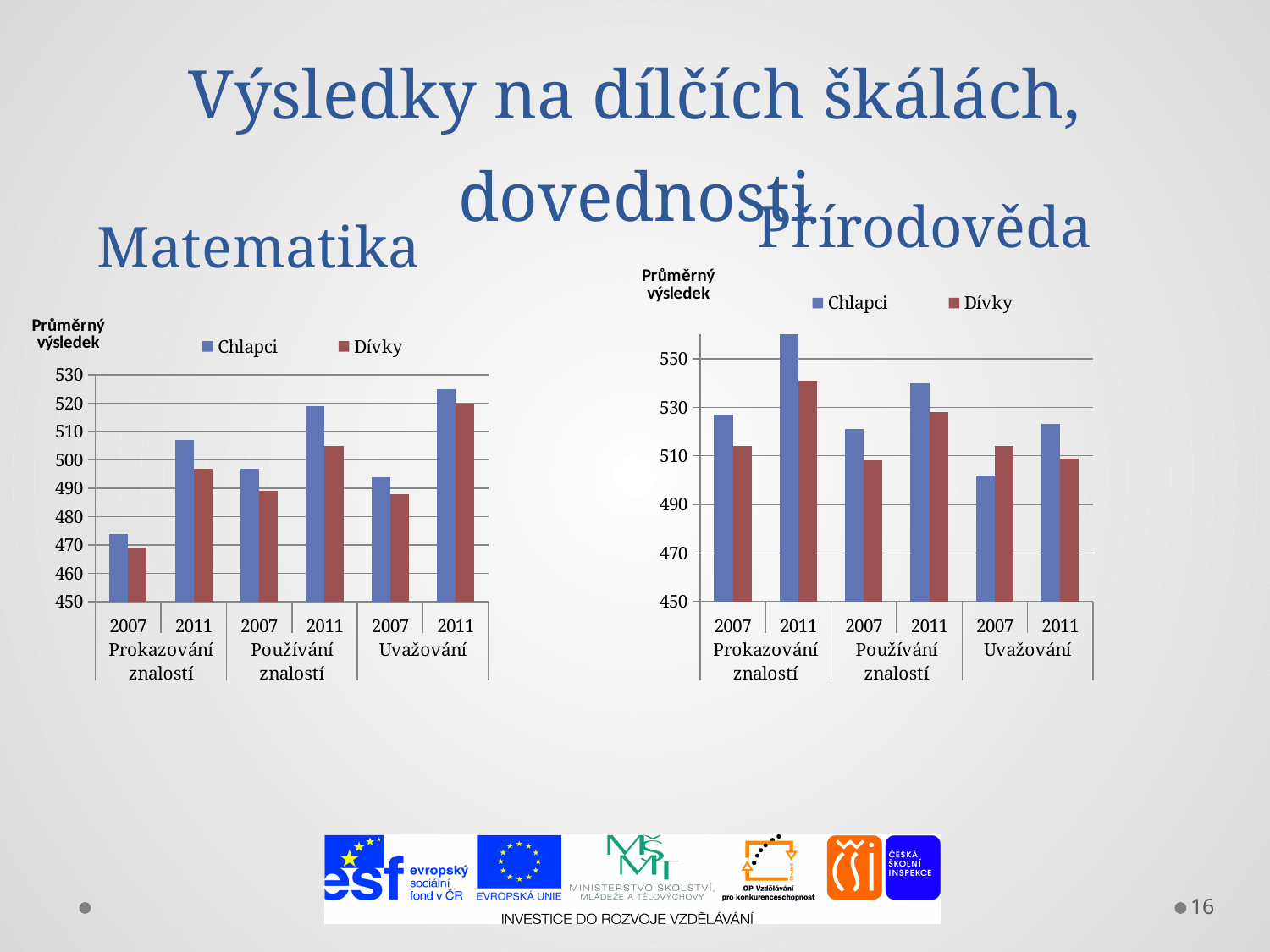
In the Přírodověda chart, which bar is the highest? Chlapci, 2011 Prokazování znalostí In the Matematika chart, is the Dívky value for 2007 Prokazování znalostí greater or less than 480? less In the Přírodověda chart, is the Chlapci value for 2007 Uvažování greater or less than 510? less In the Matematika chart, which bar is the lowest? Dívky, 2007 Prokazování znalostí In the Přírodověda chart, is the Chlapci value for 2011 Prokazování znalostí greater or less than 550? greater What are the two series named in the legend of the Matematika chart? Chlapci and Dívky In the Matematika chart, do the Chlapci values rise or fall from 2007 to 2011 within each skill area? rise What kind of chart is the Matematika chart? bar chart How many series does the legend of the Přírodověda chart list? 2 How many year categories are shown along the x axis of the Matematika chart? 6 In the Matematika chart, for 2011 Používání znalostí, which is larger: Chlapci or Dívky? Chlapci